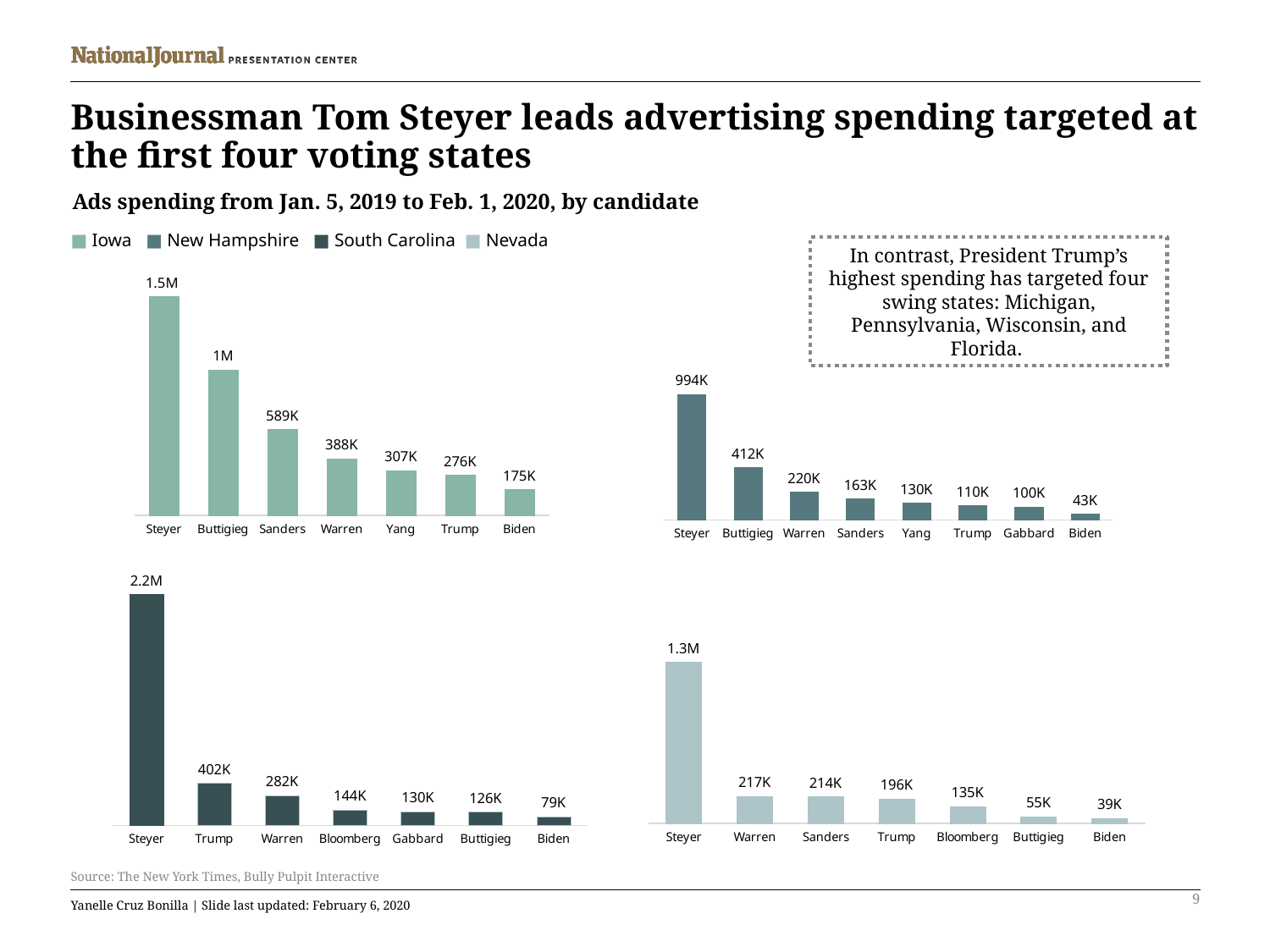
In the top-left (Iowa) chart, what is the ad spending value for Sanders? 589K In the bottom-left (South Carolina) chart, which candidate has the highest ad spending? Steyer In the bottom-left (South Carolina) chart, how much more did Trump spend than Warren? 120K How many states does the legend list? 4 What type of chart is used on this slide? Bar chart In the bottom-left (South Carolina) chart, what is the ad spending value for Trump? 402K In the top-left (Iowa) chart, what is the difference between Sanders's and Warren's ad spending? 201K In the top-left (Iowa) chart, who spent more, Yang or Trump? Yang In the bottom-right (Nevada) chart, what is the ad spending value for Bloomberg? 135K How many candidates are shown in the top-right (New Hampshire) chart? 8 In the top-right (New Hampshire) chart, what is the ad spending value for Buttigieg? 412K In the top-right (New Hampshire) chart, which candidate has the lowest ad spending? Biden